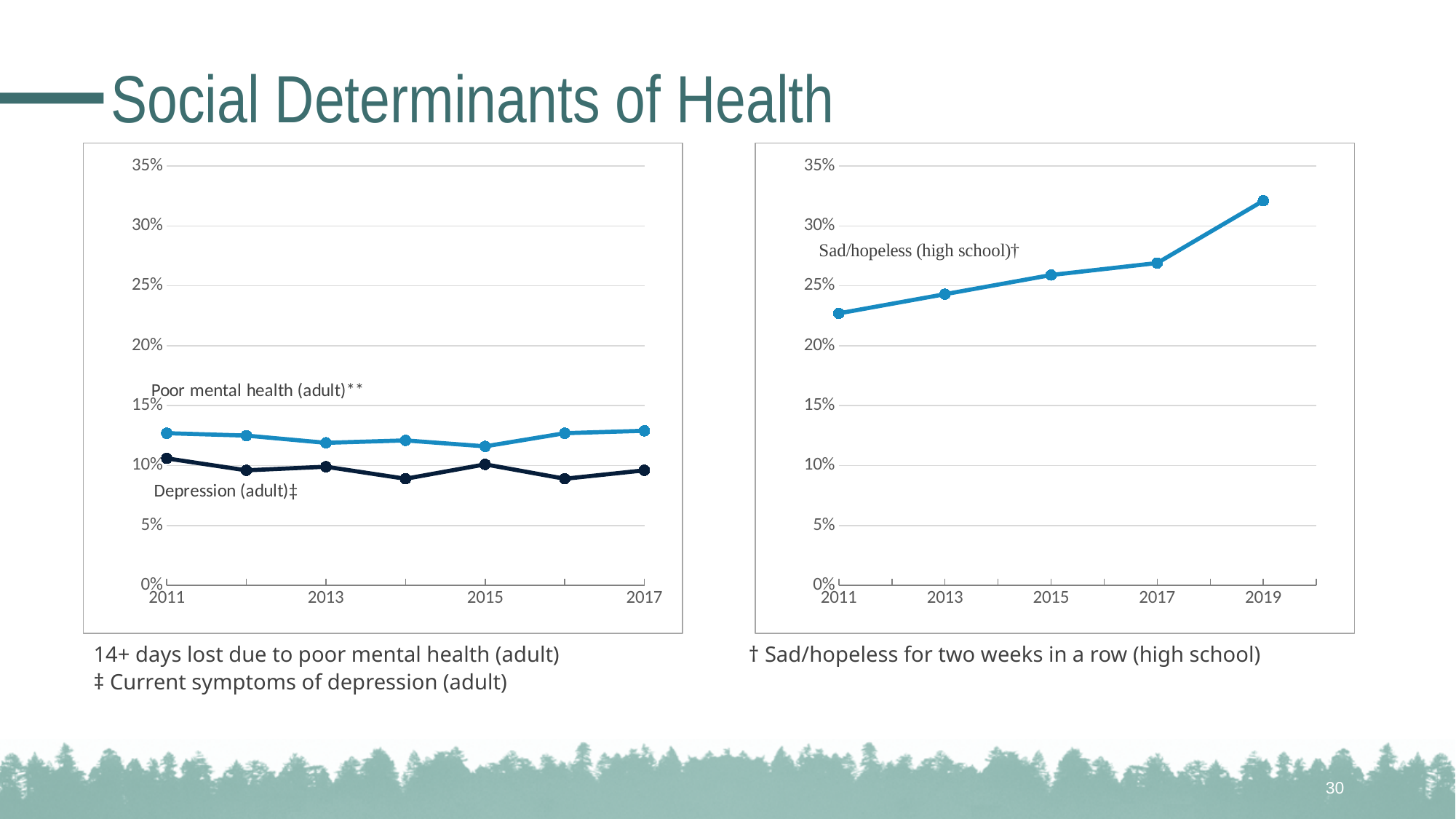
On the left chart, is the value for Poor mental health (adult) in 2011 greater or less than 10%? greater How many series are plotted on the left chart? 2 On the right chart, which year has the highest value for Sad/hopeless (high school)? 2019 On the right chart, does the Sad/hopeless (high school) line rise or fall from 2011 to 2019? rise On the right chart, is the value for Sad/hopeless (high school) in 2011 greater or less than 25%? less How many years are plotted on the left chart? 7 On the right chart, is the value for Sad/hopeless (high school) in 2019 greater or less than 30%? greater How many years are plotted on the right chart (Sad/hopeless (high school))? 5 On the right chart, which year has the lowest value for Sad/hopeless (high school)? 2011 On the left chart, which series is higher in 2017, Poor mental health (adult) or Depression (adult)? Poor mental health (adult) What kind of chart is the left chart on the slide? line chart